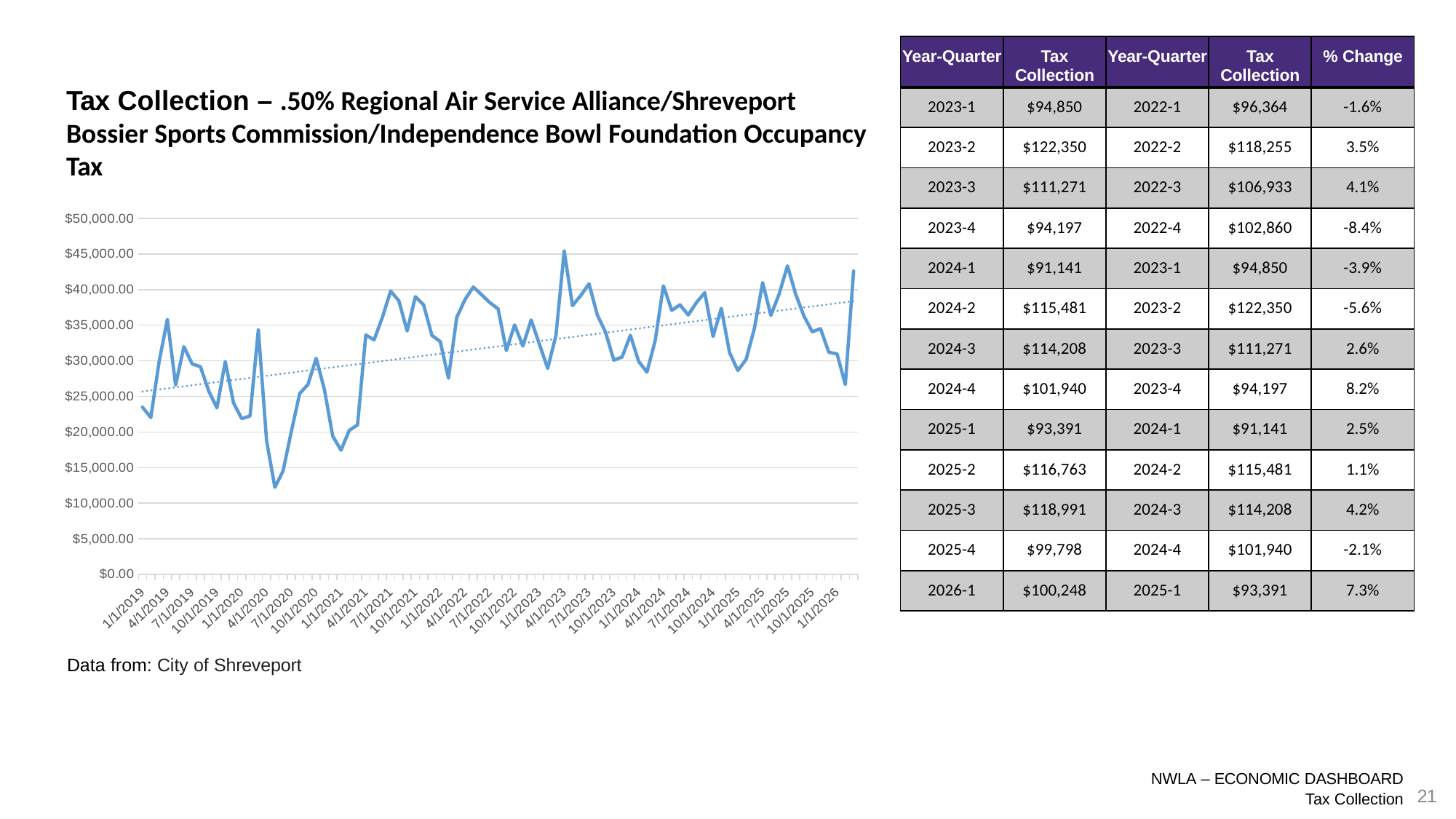
What kind of chart is shown on the slide? Line chart What is the source of the data shown in the chart? City of Shreveport Is the value for 1/1/2021 greater or less than $20,000.00? less Is the value for 7/1/2021 greater or less than $35,000.00? greater Is the value for 7/1/2020 greater or less than $15,000.00? greater Is the value for 4/1/2023 larger or smaller than the value for 7/1/2020? larger According to the dotted trendline, do tax collections generally rise or fall from 2019 to 2026? Rise What is the highest value shown on the y-axis of the chart? $50,000.00